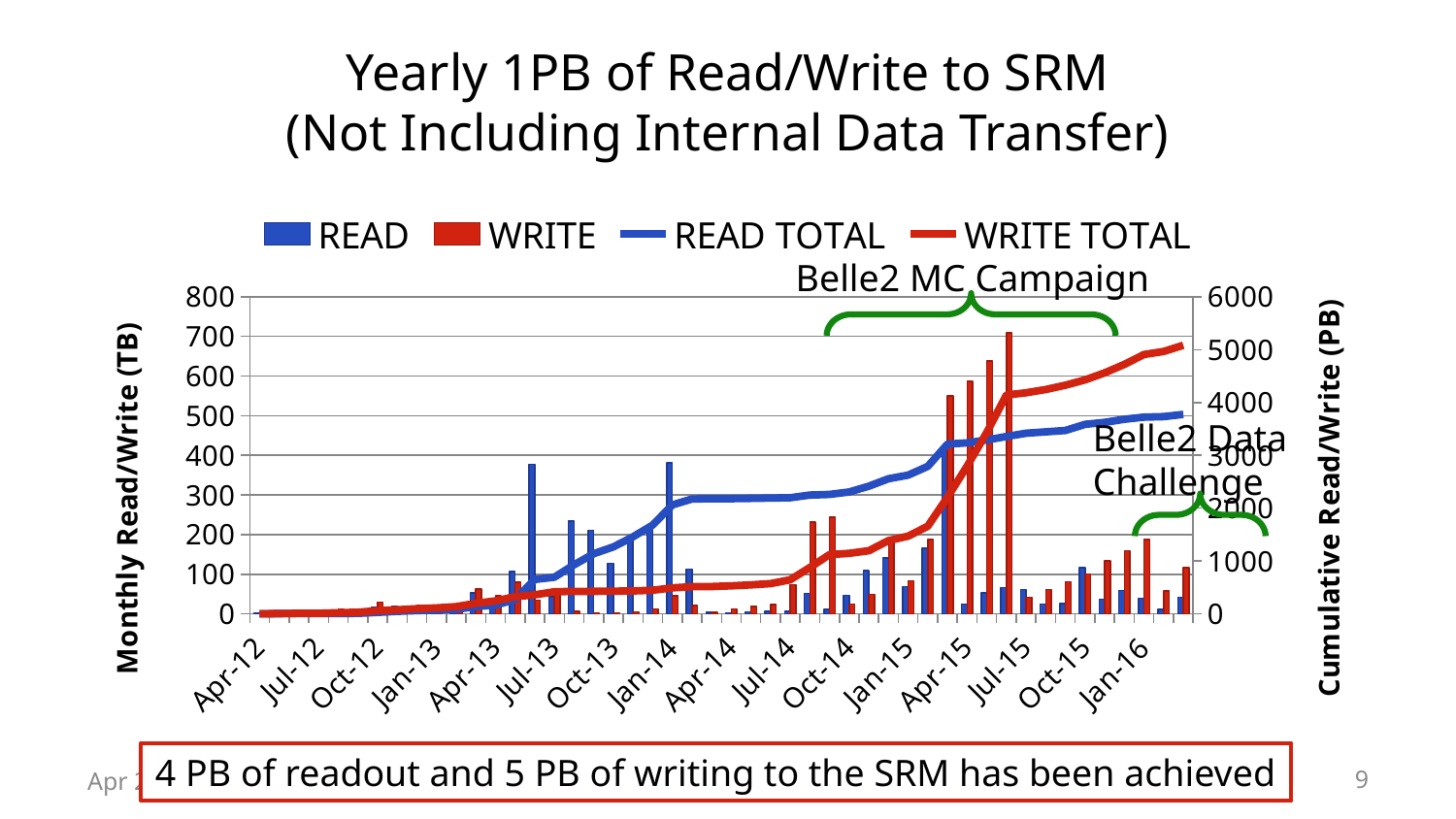
How many series does the chart legend list? 4 Does the READ TOTAL line rise or fall from Apr-12 to Jan-16? Rise What kind of chart is shown on the slide? Combined bar and line chart What is the title of the left vertical axis? Monthly Read/Write (TB) What is the title of the right vertical axis? Cumulative Read/Write (PB) How many date labels are shown along the x axis? 16 Is the WRITE TOTAL line at the right end of the chart greater or less than 4000 on the right axis? greater Is the READ TOTAL line at the right end of the chart greater or less than 3000 on the right axis? greater Which cumulative line is higher at the right end of the chart, READ TOTAL or WRITE TOTAL? WRITE TOTAL Is the tallest WRITE bar greater or less than 600 on the left axis? greater Which bar series has the tallest monthly bar on the chart, READ or WRITE? WRITE